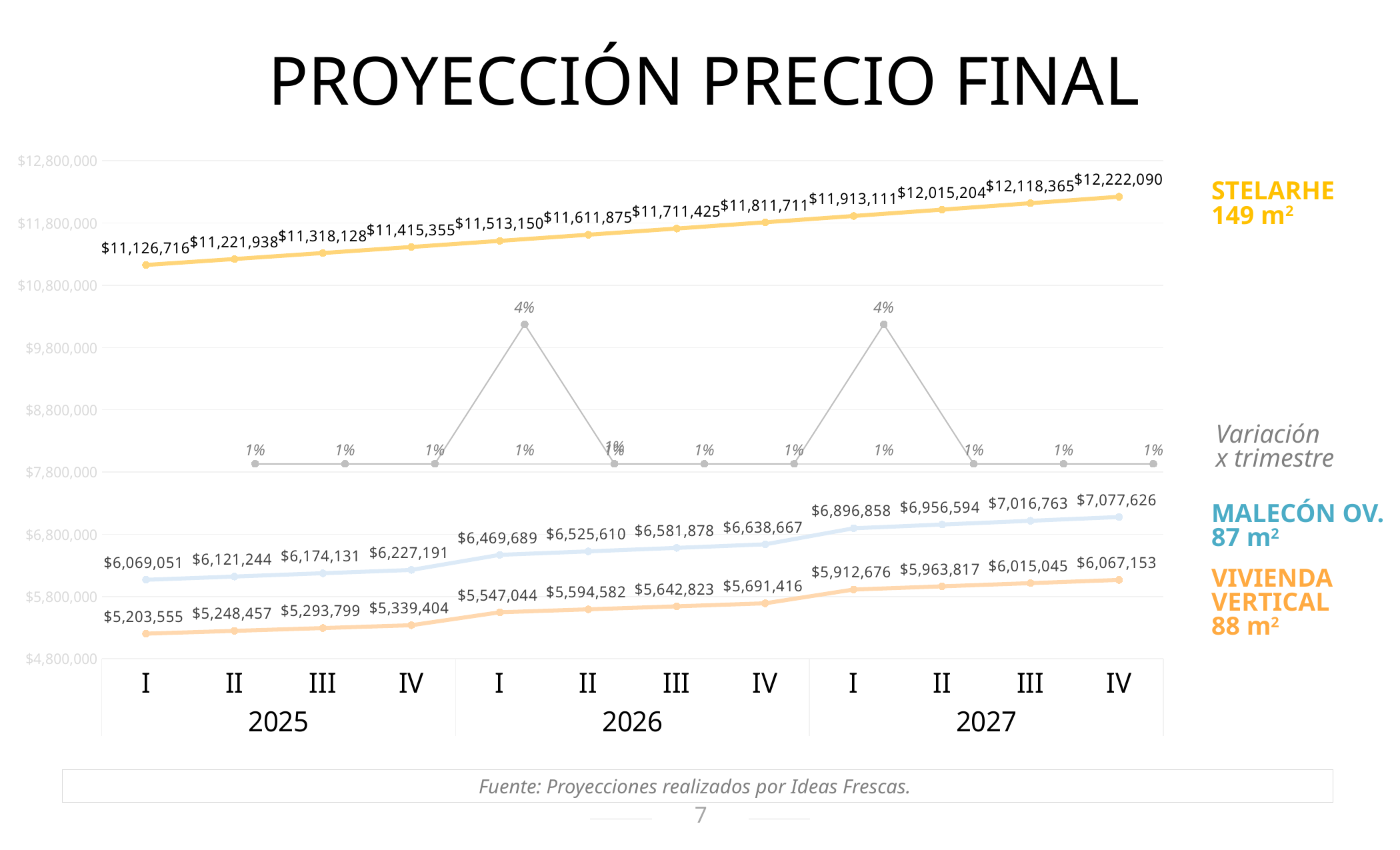
Do the projected prices for VIVIENDA VERTICAL rise or fall from 2025 to 2027? Rise What is the quarterly variation shown for quarter I of 2026? 4% How many quarters are plotted along the x axis? 12 What is the projected final price for VIVIENDA VERTICAL in quarter II of 2026? $5,594,582 What kind of chart is shown on the slide? Line chart Which project has the highest projected final price in quarter IV of 2027? STELARHE What is the difference between the MALECÓN OV. price and the VIVIENDA VERTICAL price in quarter I of 2027? $984,182 What is the projected final price for MALECÓN OV. in quarter IV of 2027? $7,077,626 Which is larger: the MALECÓN OV. price in quarter IV of 2027 or the STELARHE price in quarter I of 2025? STELARHE price in quarter I of 2025 Which project has the lowest projected final price in quarter I of 2025? VIVIENDA VERTICAL By how much does the STELARHE projected price increase from quarter I of 2025 to quarter IV of 2027? $1,095,374 What is the projected final price for STELARHE in quarter I of 2025? $11,126,716